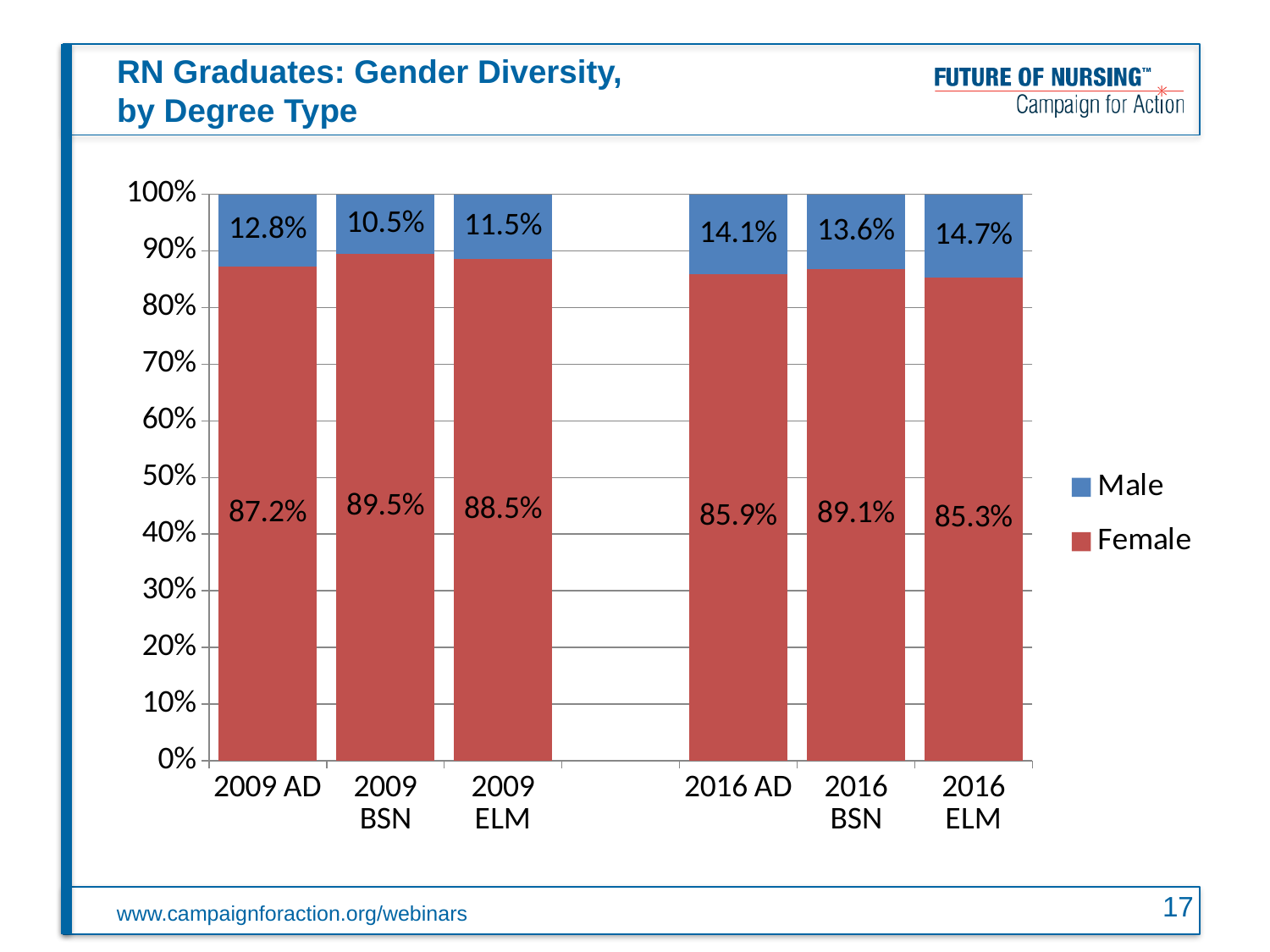
Which is larger, the Female percentage for 2009 BSN or for 2016 BSN? 2009 BSN Which colour represents Female in the chart? Red What is the Male percentage for 2009 BSN? 10.5% What kind of chart is shown on the slide? Stacked bar chart Which category has the highest Male percentage? 2016 ELM What is the difference between the Male percentage for 2016 AD and 2009 AD? 1.3% How many series does the legend list? 2 What is the Male percentage for 2016 ELM? 14.7% What is the Female percentage for 2009 AD? 87.2% How many categories are shown on the x axis? 6 Which category has the lowest Female percentage? 2016 ELM